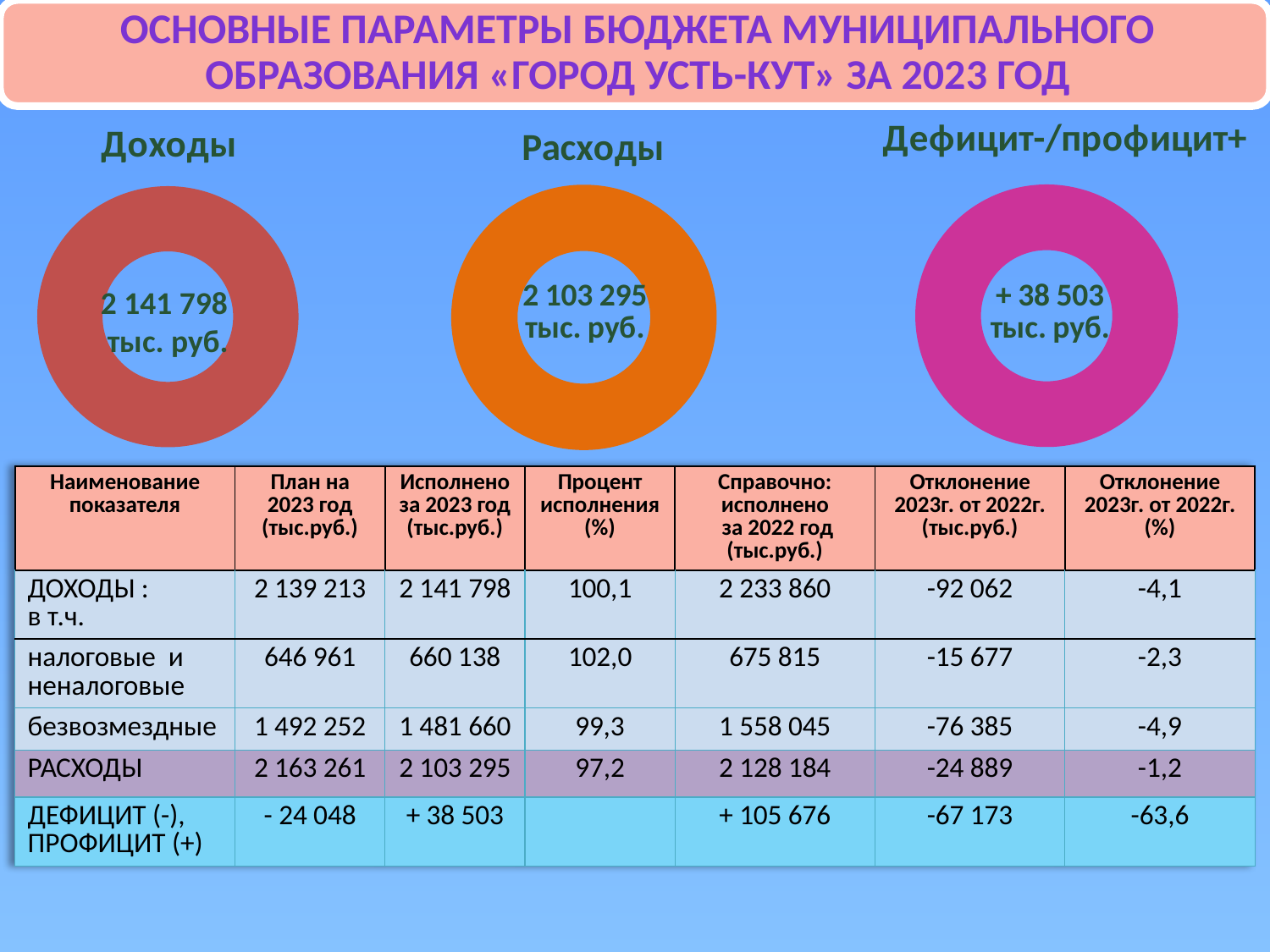
What is the difference between the value in the "Доходы" chart and the value in the "Расходы" chart? 38 503 тыс. руб. How many donut charts are shown on the slide? 3 Is the value in the "Расходы" chart greater or less than 2 000 000 тыс. руб.? greater Which of the three donut charts shows the largest value? Доходы What value is shown in the centre of the "Дефицит-/профицит+" donut chart? + 38 503 тыс. руб. Which is larger, the value in the "Доходы" chart or the value in the "Расходы" chart? Доходы What value is shown in the centre of the "Доходы" donut chart? 2 141 798 тыс. руб. What colour is the "Расходы" donut chart? Orange What value is shown in the centre of the "Расходы" donut chart? 2 103 295 тыс. руб. What kind of chart is used to display "Доходы", "Расходы" and "Дефицит-/профицит+"? Donut chart Which of the three donut charts shows the smallest value? Дефицит-/профицит+ What colour is the "Дефицит-/профицит+" donut chart? Magenta (pink-purple)